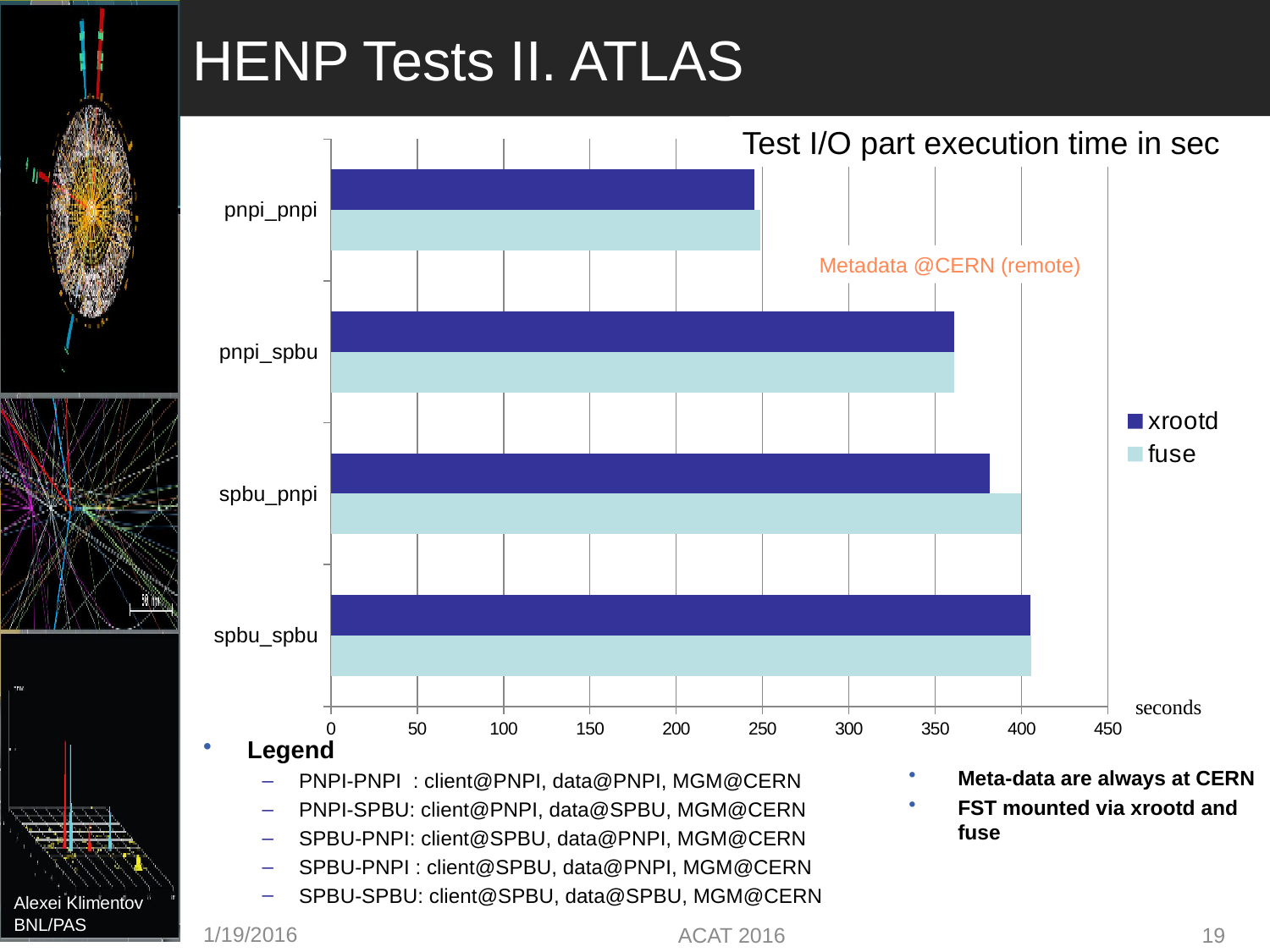
Which category has the lowest fuse execution time? pnpi_pnpi Which category has the larger fuse value, pnpi_pnpi or spbu_spbu? spbu_spbu What are the two series named in the chart legend? xrootd and fuse What kind of chart is shown on the slide? bar chart Which category has the highest xrootd execution time? spbu_spbu Which is larger for spbu_pnpi, the xrootd value or the fuse value? fuse Is the xrootd value for pnpi_pnpi greater or less than 250? less Is the xrootd value for pnpi_spbu greater or less than 350? greater How many series does the chart legend list? 2 How many categories are plotted on the chart? 4 What is the title of the chart? Test I/O part execution time in sec Is the fuse value for spbu_spbu greater or less than 400? greater